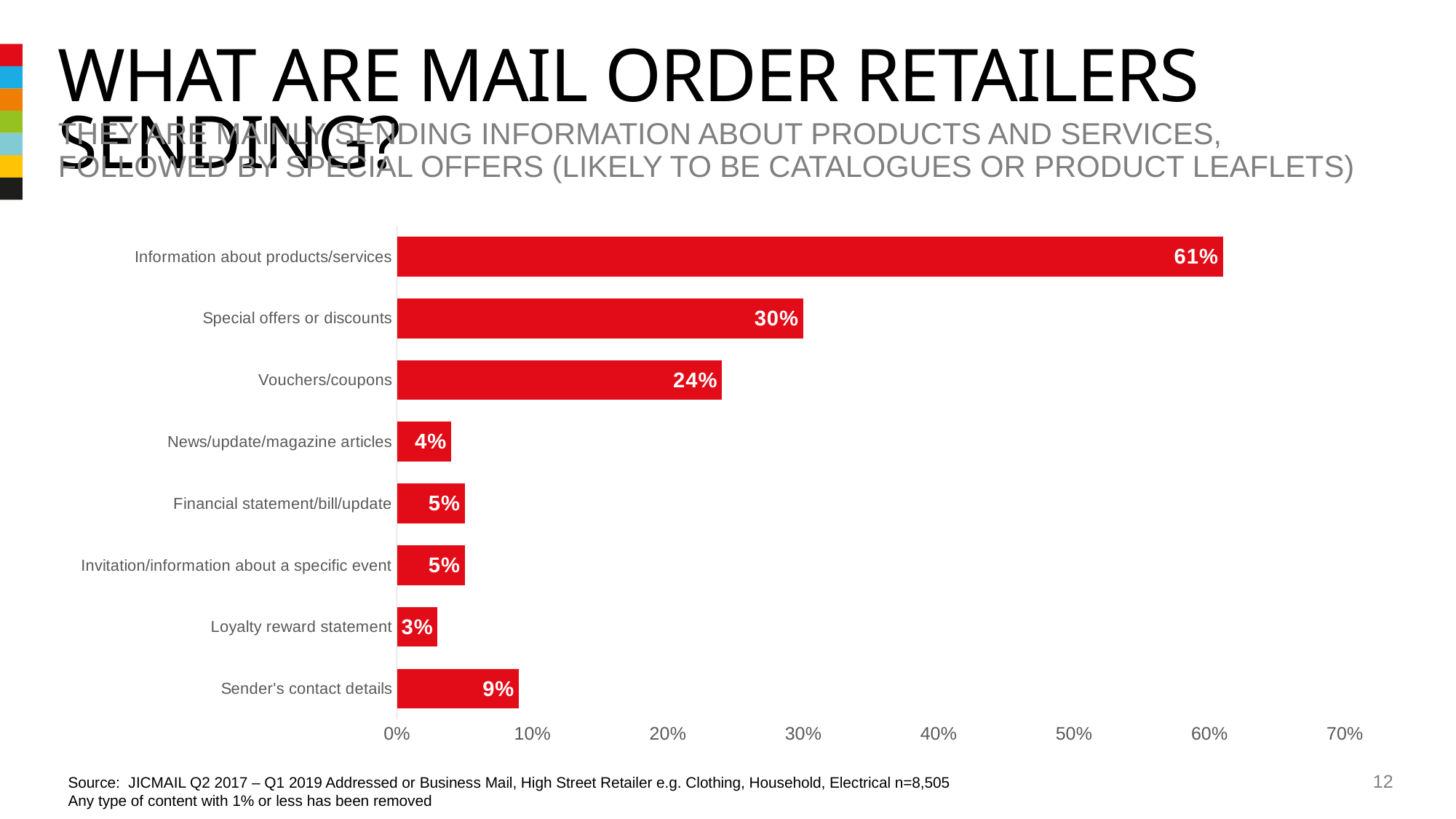
Which category has the lowest value? Loyalty reward statement Which category has the highest value? Information about products/services Is the value for Special offers or discounts greater or less than 20%? greater What is the difference between Sender's contact details and News/update/magazine articles? 5% How many categories are shown in the chart? 8 What is the value for Information about products/services? 61% What is the highest value shown on the x axis? 70% What is the difference between Information about products/services and Special offers or discounts? 31% Which is larger, Special offers or discounts or Vouchers/coupons? Special offers or discounts What kind of chart is shown on the slide? bar chart What is the value for Vouchers/coupons? 24% What is the value for Sender's contact details? 9%